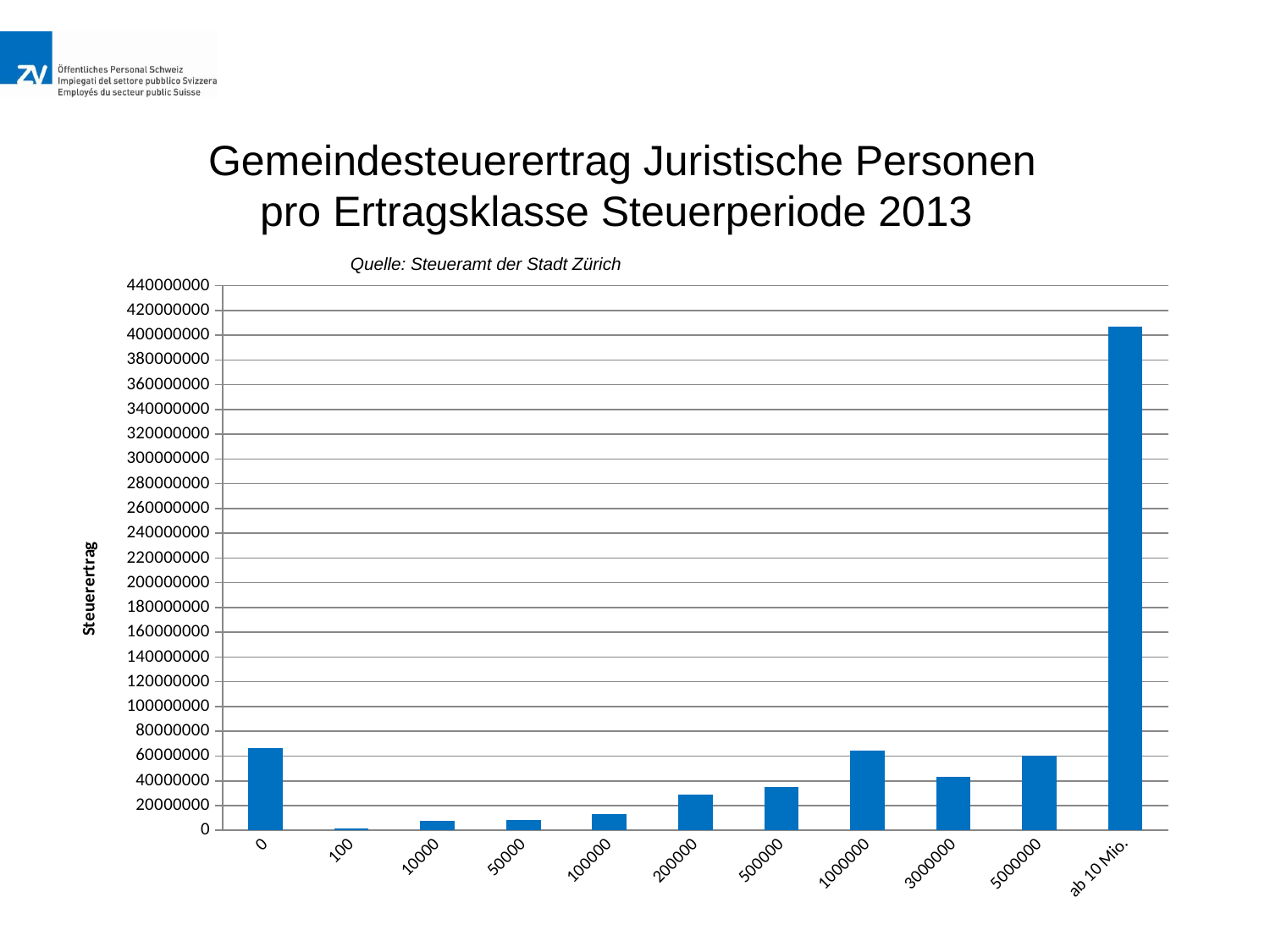
What is the label of the vertical axis? Steuerertrag Which category has the highest Steuerertrag? ab 10 Mio. Is the value for 'ab 10 Mio.' greater or less than 380000000? greater Is the value for the category '200000' greater or less than 20000000? greater How many categories (Ertragsklassen) are shown on the x axis? 11 Is the value for the category '3000000' greater or less than 60000000? less What source is cited above the chart? Quelle: Steueramt der Stadt Zürich What kind of chart is shown on the slide? bar chart Which has a larger Steuerertrag: the category '0' or the category '100'? 0 Which has a larger Steuerertrag: the category '1000000' or the category '3000000'? 1000000 Which category has the lowest Steuerertrag? 100